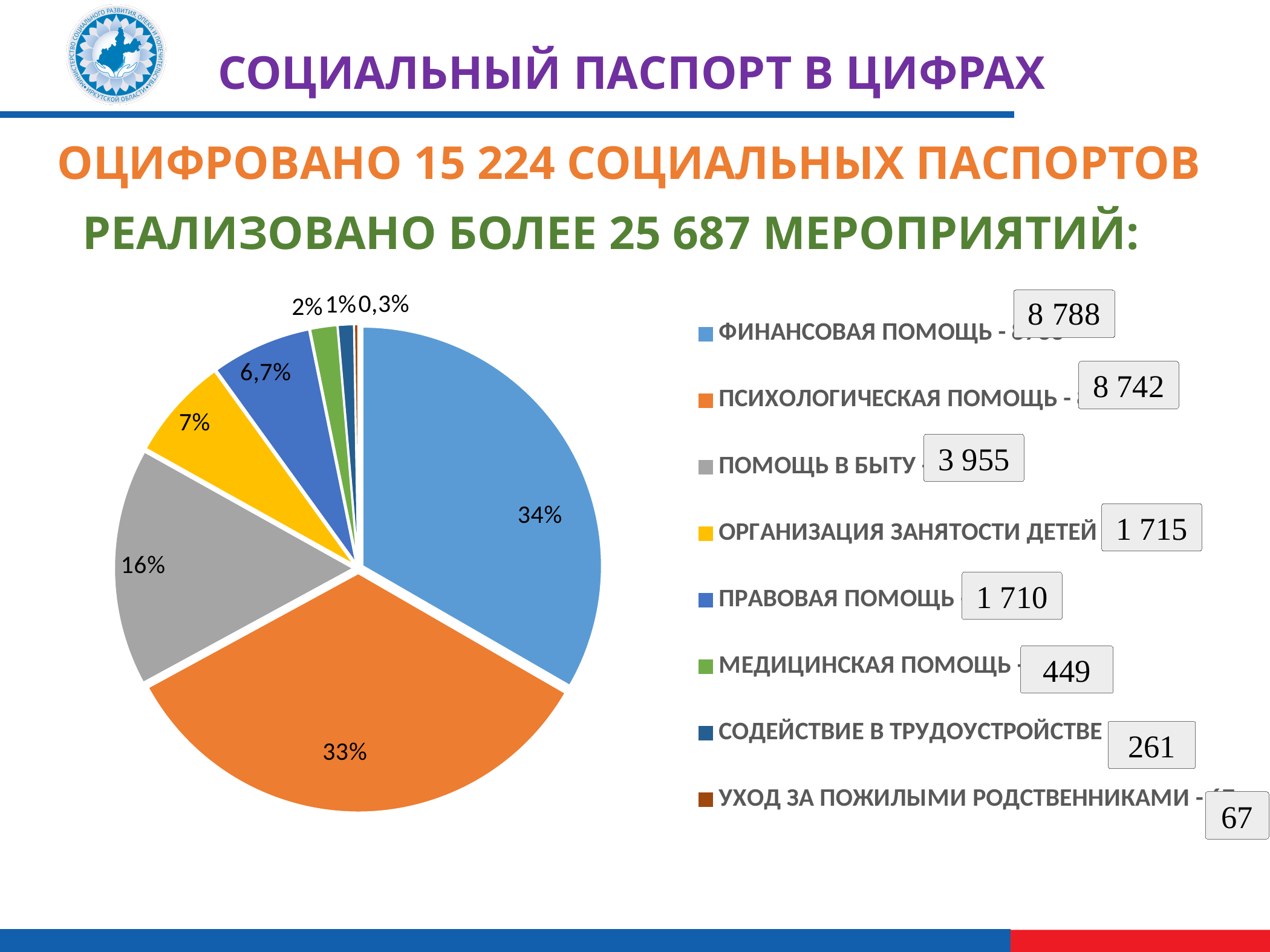
What kind of chart is shown on the slide? pie chart What percentage is shown for ПРАВОВАЯ ПОМОЩЬ? 6,7% Which has a larger share: ОРГАНИЗАЦИЯ ЗАНЯТОСТИ ДЕТЕЙ or ПРАВОВАЯ ПОМОЩЬ? ОРГАНИЗАЦИЯ ЗАНЯТОСТИ ДЕТЕЙ What share of the pie does ПОМОЩЬ В БЫТУ take? 16% What share of the pie does ФИНАНСОВАЯ ПОМОЩЬ take? 34% How many categories does the pie chart have? 8 What colour is the slice for ПОМОЩЬ В БЫТУ? grey Which category has the smallest slice of the pie? УХОД ЗА ПОЖИЛЫМИ РОДСТВЕННИКАМИ What value is shown for МЕДИЦИНСКАЯ ПОМОЩЬ in the legend? 449 What is the difference between the values for ФИНАНСОВАЯ ПОМОЩЬ (8 788) and ПСИХОЛОГИЧЕСКАЯ ПОМОЩЬ (8 742)? 46 What value is shown for ПСИХОЛОГИЧЕСКАЯ ПОМОЩЬ in the legend? 8 742 Which category has the largest slice of the pie? ФИНАНСОВАЯ ПОМОЩЬ